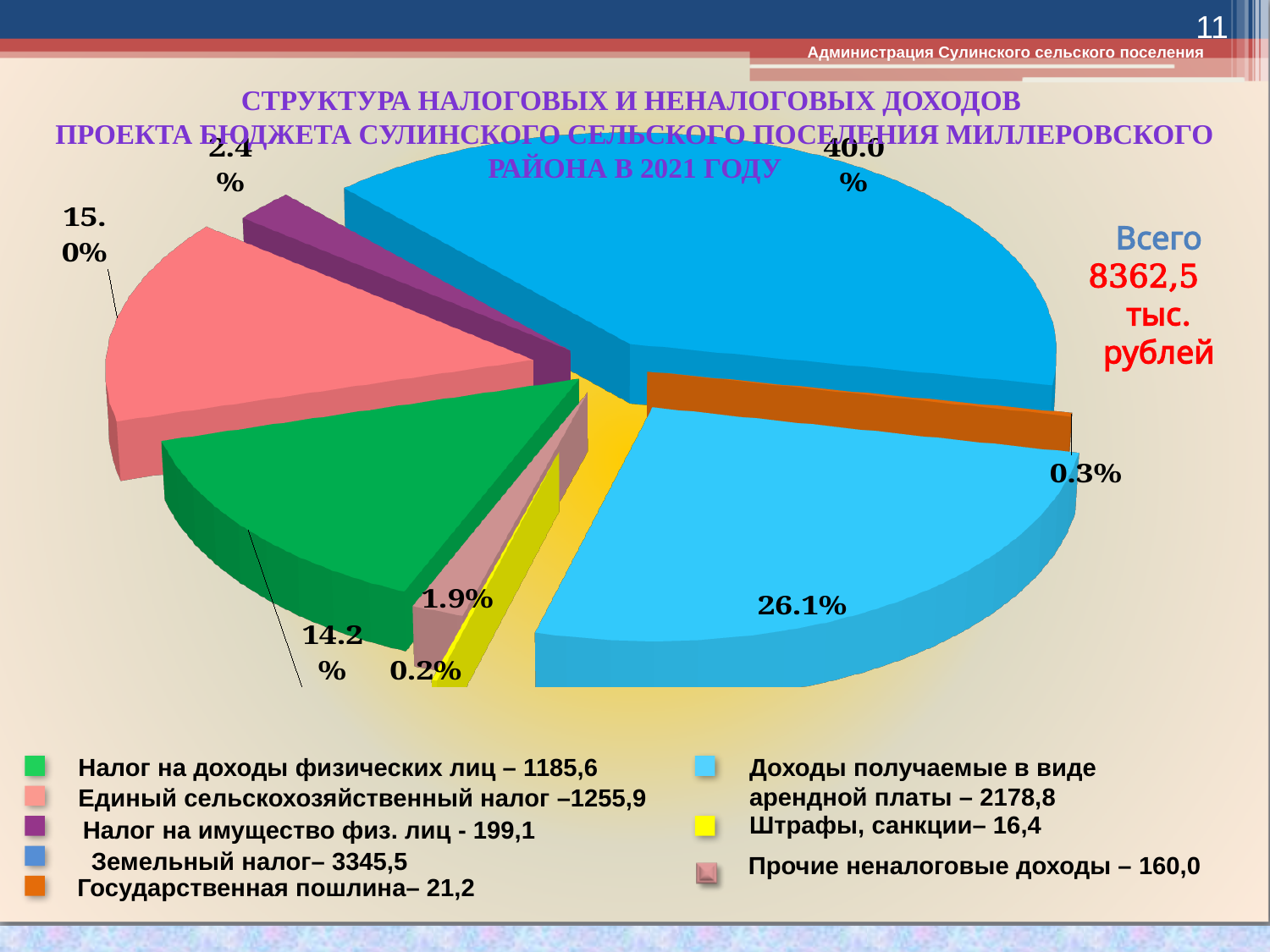
What is the difference in percentage points between the Земельный налог slice (40.0%) and the арендной платы slice (26.1%)? 13.9 What kind of chart is shown on the slide? pie chart What value does the legend give for Земельный налог? 3345,5 Which has the larger share: Налог на доходы физических лиц or Единый сельскохозяйственный налог? Единый сельскохозяйственный налог How many slices does the pie chart have? 8 Which category has the largest share of the pie? Земельный налог What total amount is stated next to the pie chart? 8362,5 тыс. рублей What value does the legend give for Штрафы, санкции? 16,4 Which category has the smallest share of the pie? Штрафы, санкции What share of the pie is labelled for Государственная пошлина? 0.3% What share of the pie is labelled for Единый сельскохозяйственный налог? 15.0% What share of the pie is labelled for Доходы получаемые в виде арендной платы? 26.1%